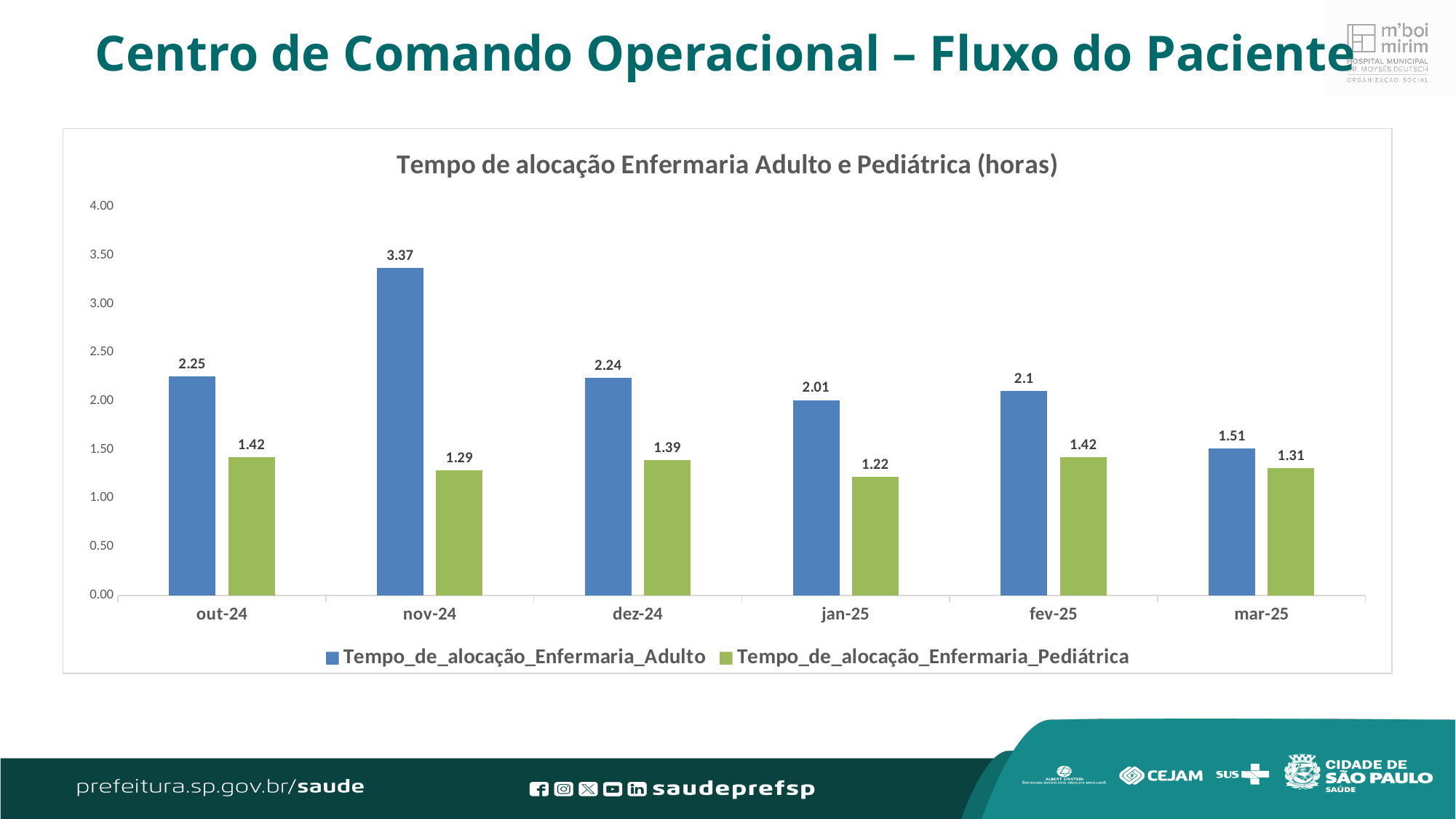
What kind of chart is shown on the slide? bar chart What is the value for Tempo_de_alocação_Enfermaria_Pediátrica in jan-25? 1.22 What is the value for Tempo_de_alocação_Enfermaria_Adulto in mar-25? 1.51 What is the title of the chart? Tempo de alocação Enfermaria Adulto e Pediátrica (horas) How many series does the legend list? 2 What is the difference between the Adulto and Pediátrica values in nov-24? 2.08 How many months are shown on the x axis? 6 Which month has the lowest value for Tempo_de_alocação_Enfermaria_Pediátrica? jan-25 Which month has the highest value for Tempo_de_alocação_Enfermaria_Adulto? nov-24 What is the value for Tempo_de_alocação_Enfermaria_Adulto in nov-24? 3.37 Which is larger in fev-25: the Adulto value or the Pediátrica value? Adulto Is the value for Tempo_de_alocação_Enfermaria_Adulto in nov-24 greater or less than 3.00? greater